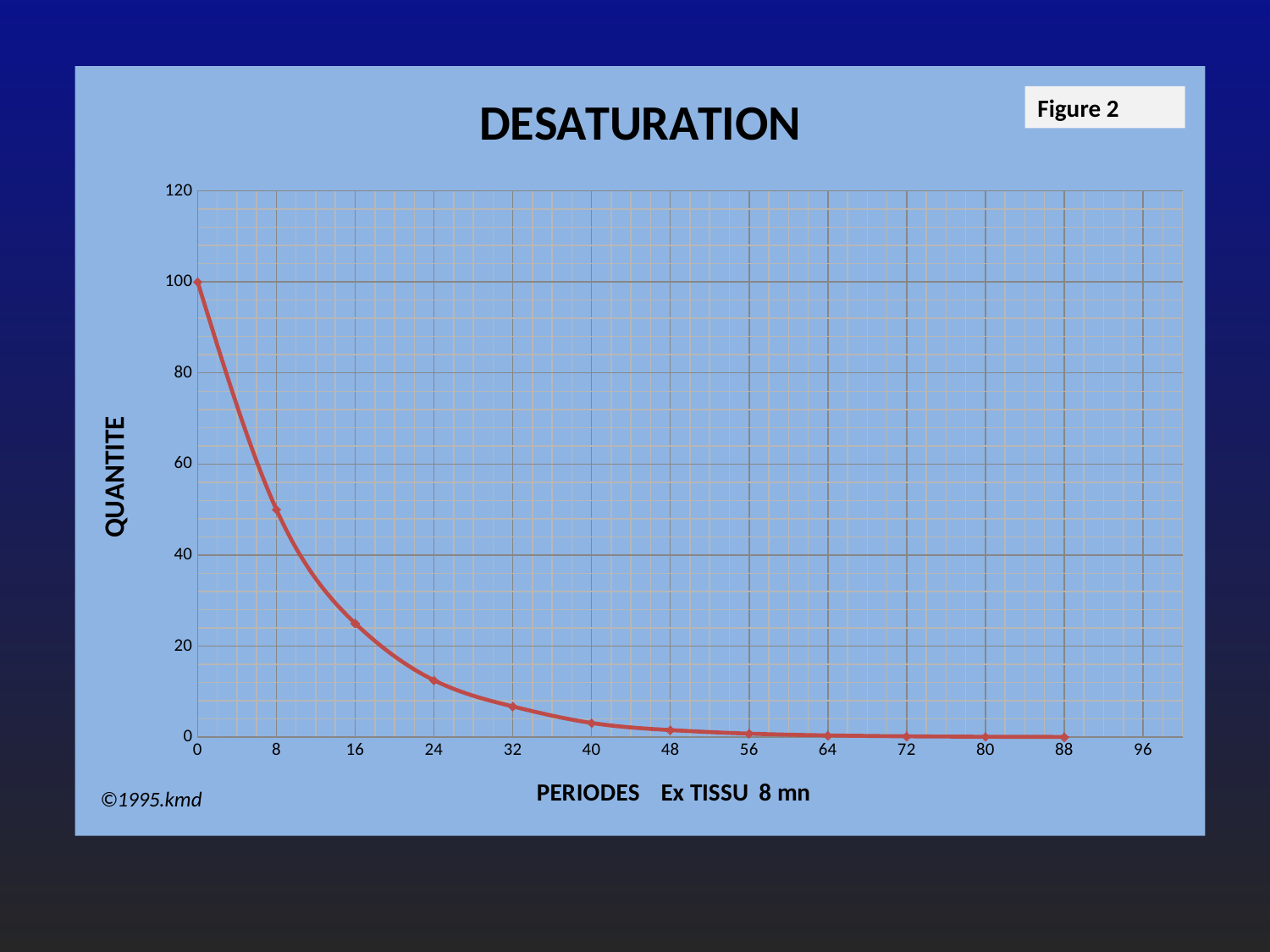
At which period is the QUANTITE value highest? 0 Do the values rise or fall as the periods increase along the x axis? fall Which has the larger value, period 8 or period 16? period 8 Is the value at period 24 greater or less than 20? less Is the value at period 8 greater or less than 60? less What is the QUANTITE value at period 0? 100 What kind of chart is shown on the slide? line chart Is the value at period 16 greater or less than 20? greater How many data points are plotted on the line? 12 What is the title of the chart? DESATURATION What is the label of the vertical axis? QUANTITE